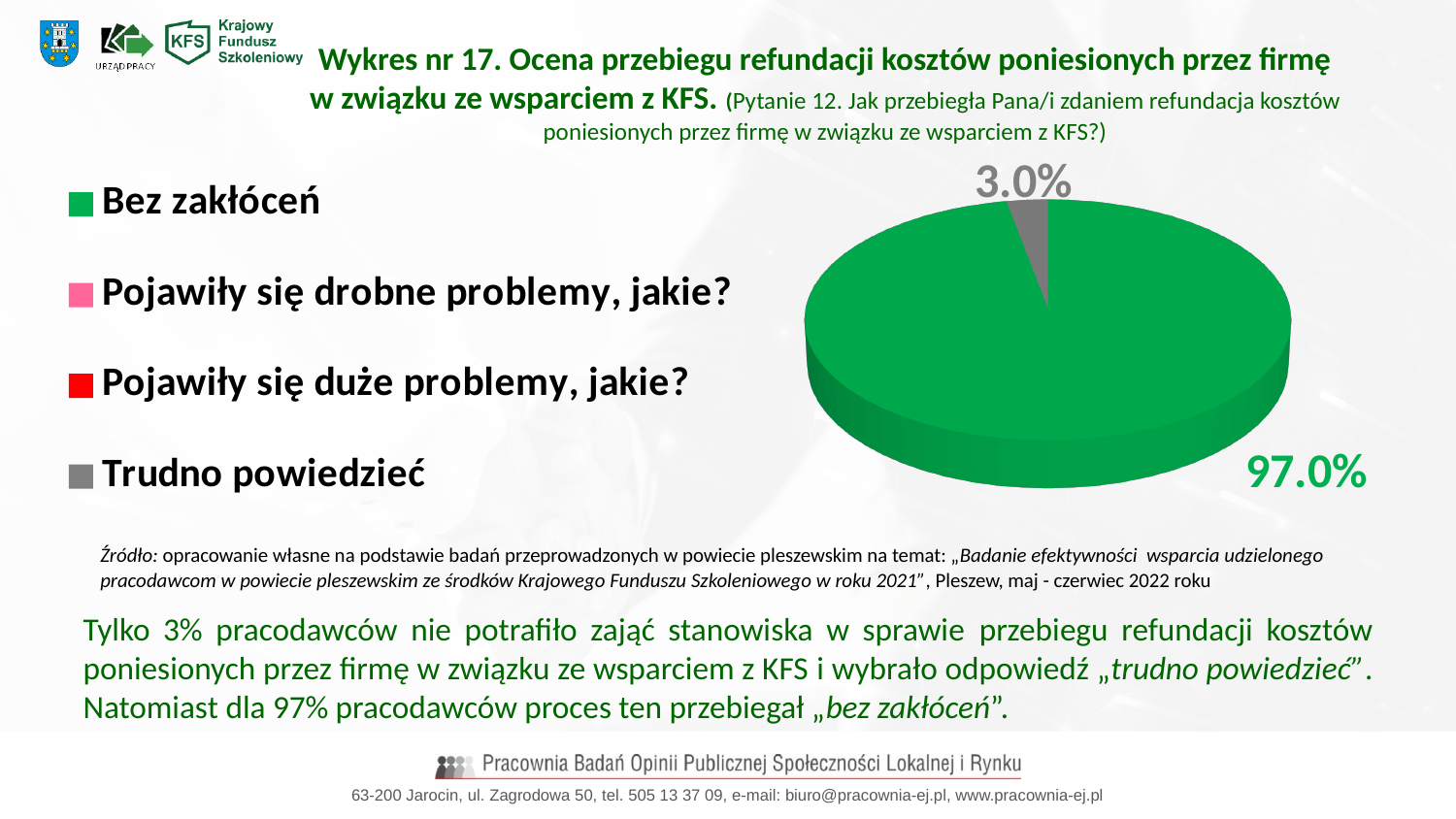
Which is larger: the slice for "Bez zakłóceń" or the slice for "Trudno powiedzieć"? Bez zakłóceń Which of the visible slices is the smallest? Trudno powiedzieć How many entries does the legend list? 4 What share of the pie does "Bez zakłóceń" represent? 97.0% What colour does the legend assign to "Pojawiły się duże problemy, jakie?"? red What is the total of the two labelled slices shown on the pie? 100.0% Is the share for "Bez zakłóceń" greater or less than 50%? greater What colour is the slice for "Bez zakłóceń"? green What share of the pie does "Trudno powiedzieć" represent? 3.0% Which category has the largest slice of the pie? Bez zakłóceń What kind of chart is shown on the slide? pie chart What is the difference in percentage points between the "Bez zakłóceń" slice and the "Trudno powiedzieć" slice? 94.0 percentage points